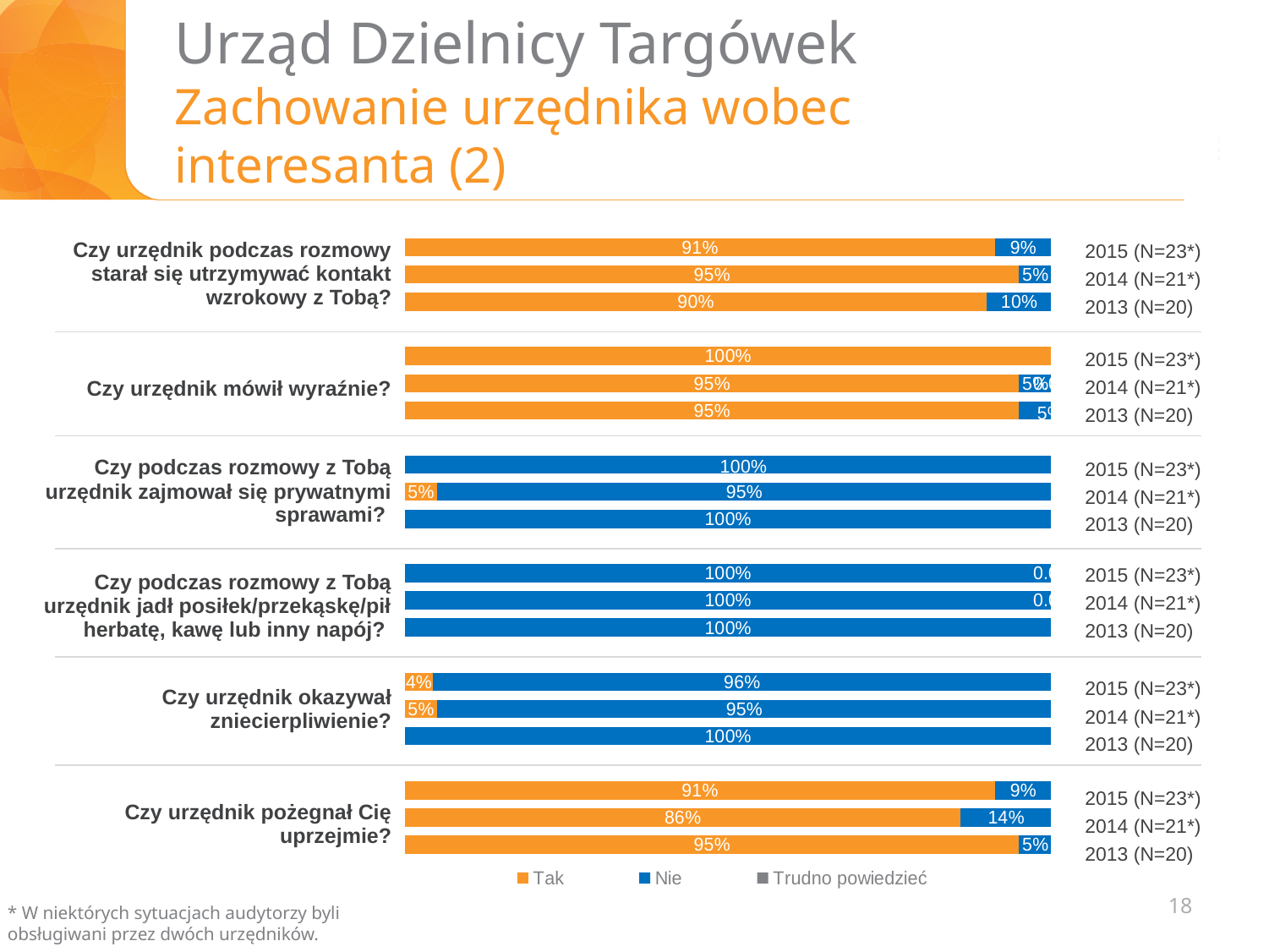
For the question 'Czy urzędnik pożegnał Cię uprzejmie?', what is the difference between the 'Tak' values for 2015 (N=23*) and 2014 (N=21*)? 5 percentage points In the chart, what is the 'Tak' value for 2015 (N=23*) for the question 'Czy urzędnik podczas rozmowy starał się utrzymywać kontakt wzrokowy z Tobą?' 91% For the question 'Czy urzędnik podczas rozmowy starał się utrzymywać kontakt wzrokowy z Tobą?', which year has the higher 'Tak' value, 2015 (N=23*) or 2014 (N=21*)? 2014 (N=21*) In the chart, what is the 'Tak' value for 2014 (N=21*) for the question 'Czy urzędnik pożegnał Cię uprzejmie?' 86% In the chart, what is the 'Nie' value for 2015 (N=23*) for the question 'Czy urzędnik okazywał zniecierpliwienie?' 96% In the chart, what is the 'Tak' value for 2014 (N=21*) for the question 'Czy podczas rozmowy z Tobą urzędnik zajmował się prywatnymi sprawami?' 5% How many survey questions are shown in the chart? 6 In the chart, what is the 'Nie' value for 2013 (N=20) for the question 'Czy urzędnik podczas rozmowy starał się utrzymywać kontakt wzrokowy z Tobą?' 10% What kind of chart is shown on the slide? Stacked bar chart In the chart, what is the 'Nie' value for 2014 (N=21*) for the question 'Czy urzędnik pożegnał Cię uprzejmie?' 14% How many series does the chart's legend list? 3 In the chart, what is the 'Tak' value for 2015 (N=23*) for the question 'Czy urzędnik mówił wyraźnie?' 100%